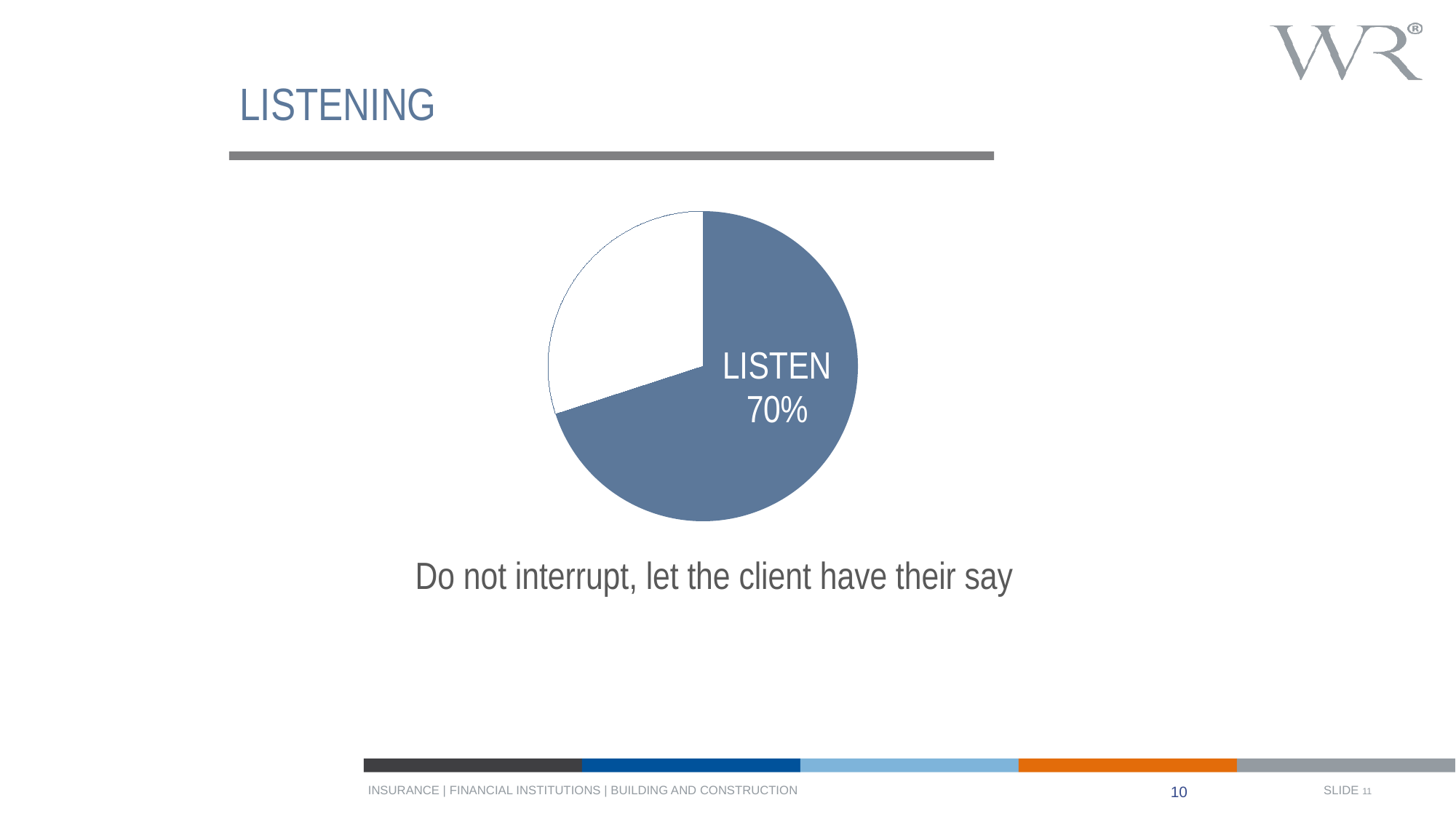
What percentage is shown for the LISTEN slice of the pie chart? 70% Is the value for the LISTEN slice greater or less than 50%? greater Which slice of the pie chart is larger, the LISTEN slice or the unlabeled white slice? LISTEN What share of the pie does the LISTEN slice represent? 70% How many slices does the pie chart have? 2 What is the title of the slide containing the pie chart? LISTENING What kind of chart is shown on the slide? pie chart What colour is the LISTEN slice of the pie chart? blue Which slice of the pie chart is the largest? LISTEN